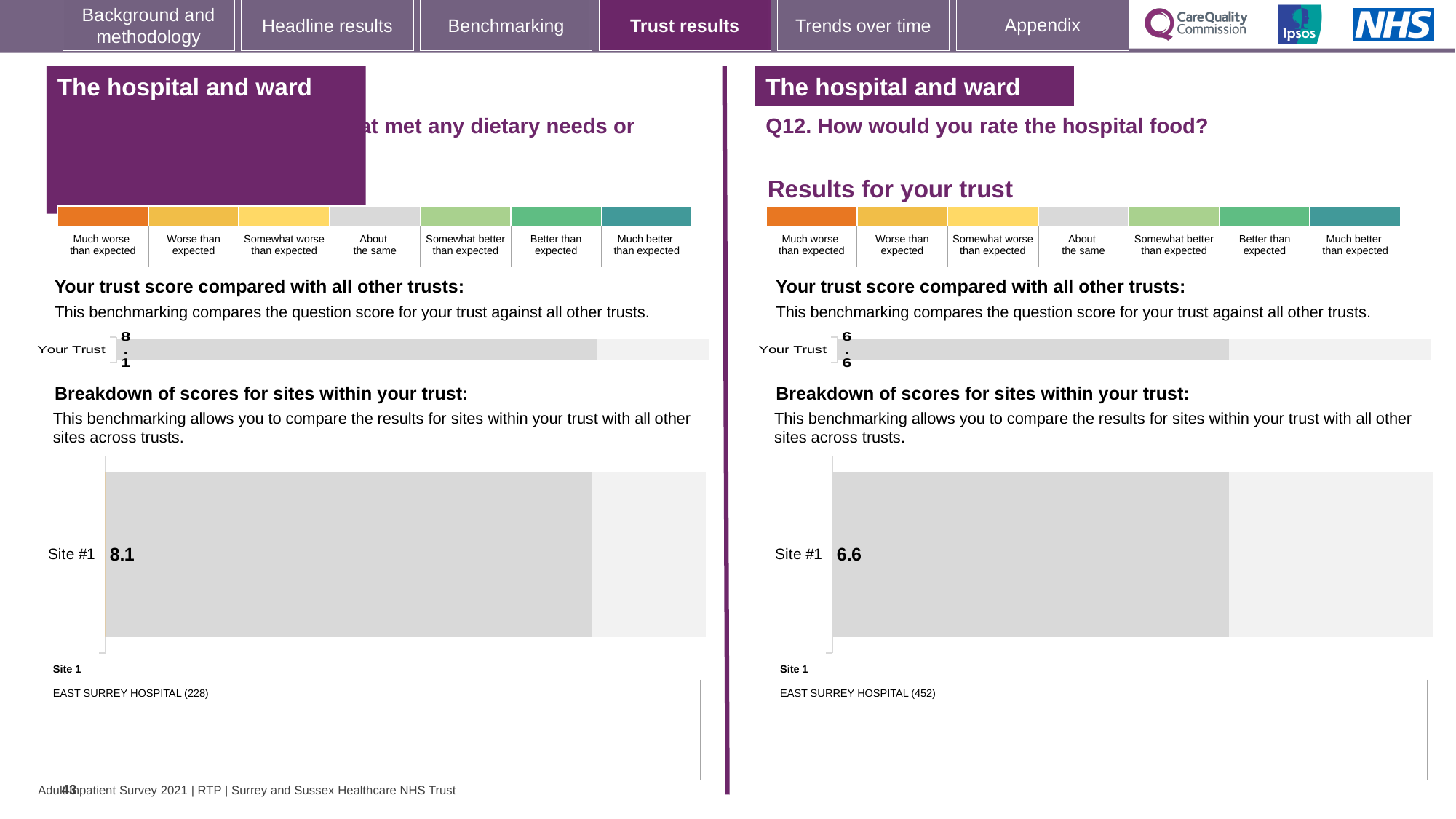
How many sites are shown in the 'Breakdown of scores for sites within your trust' chart on the right-hand panel (Q12)? 1 What is the difference between the Site #1 score on the left-hand panel (8.1) and the Site #1 score on the right-hand panel (6.6)? 1.5 What kind of chart is used to show the Site #1 score on the right-hand panel (Q12)? Bar chart What is the difference between the Your Trust score on the left-hand panel and the Your Trust score on the right-hand panel (Q12)? 1.5 How many sites are shown in the 'Breakdown of scores for sites within your trust' chart on the left-hand panel? 1 On the right-hand panel (Q12), which hospital is listed as Site 1? EAST SURREY HOSPITAL (452) On the right-hand panel (Q12. How would you rate the hospital food?), what is the score shown for Your Trust? 6.6 On the left-hand panel, what is the score shown for Site #1? 8.1 Which is larger: the Site #1 score on the left-hand panel or the Site #1 score on the right-hand panel (Q12)? Left-hand panel On the left-hand panel, which hospital is listed as Site 1? EAST SURREY HOSPITAL (228) On the right-hand panel (Q12. How would you rate the hospital food?), what is the score shown for Site #1? 6.6 On the left-hand panel, what is the score shown for Your Trust? 8.1